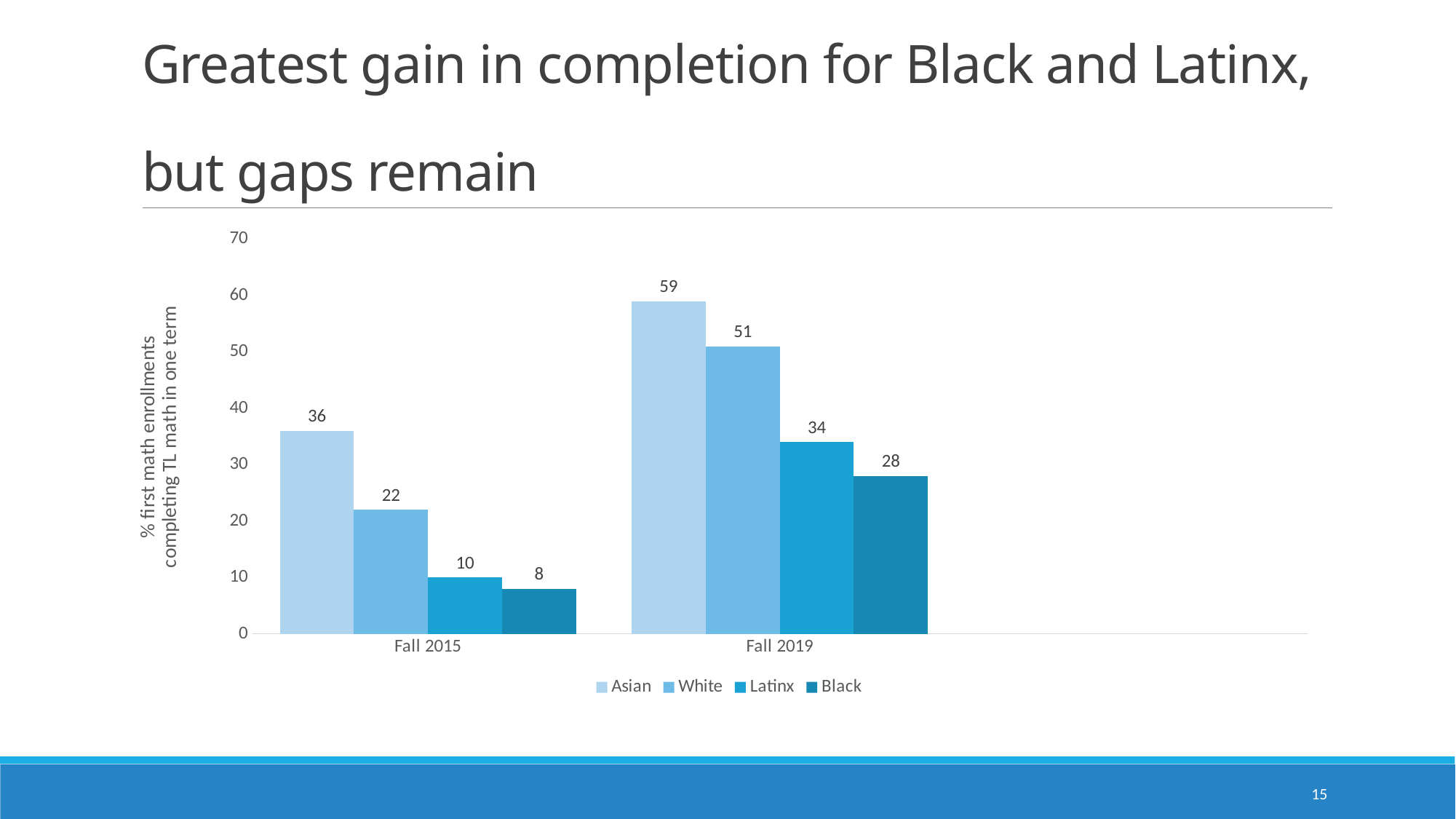
Which group has the lowest value in Fall 2015? Black What is the value for White in Fall 2019? 51 What is the value for Latinx in Fall 2015? 10 What is the label of the vertical axis? % first math enrollments completing TL math in one term What is the difference between the Asian and Black values in Fall 2019? 31 Which is larger, the White value in Fall 2015 or the Black value in Fall 2019? Black value in Fall 2019 What kind of chart is shown on the slide? Bar chart How many series does the legend list? 4 What is the difference between the Latinx values in Fall 2019 and Fall 2015? 24 What is the value for Asian in Fall 2015? 36 Which group has the highest value in Fall 2019? Asian What is the value for Black in Fall 2019? 28